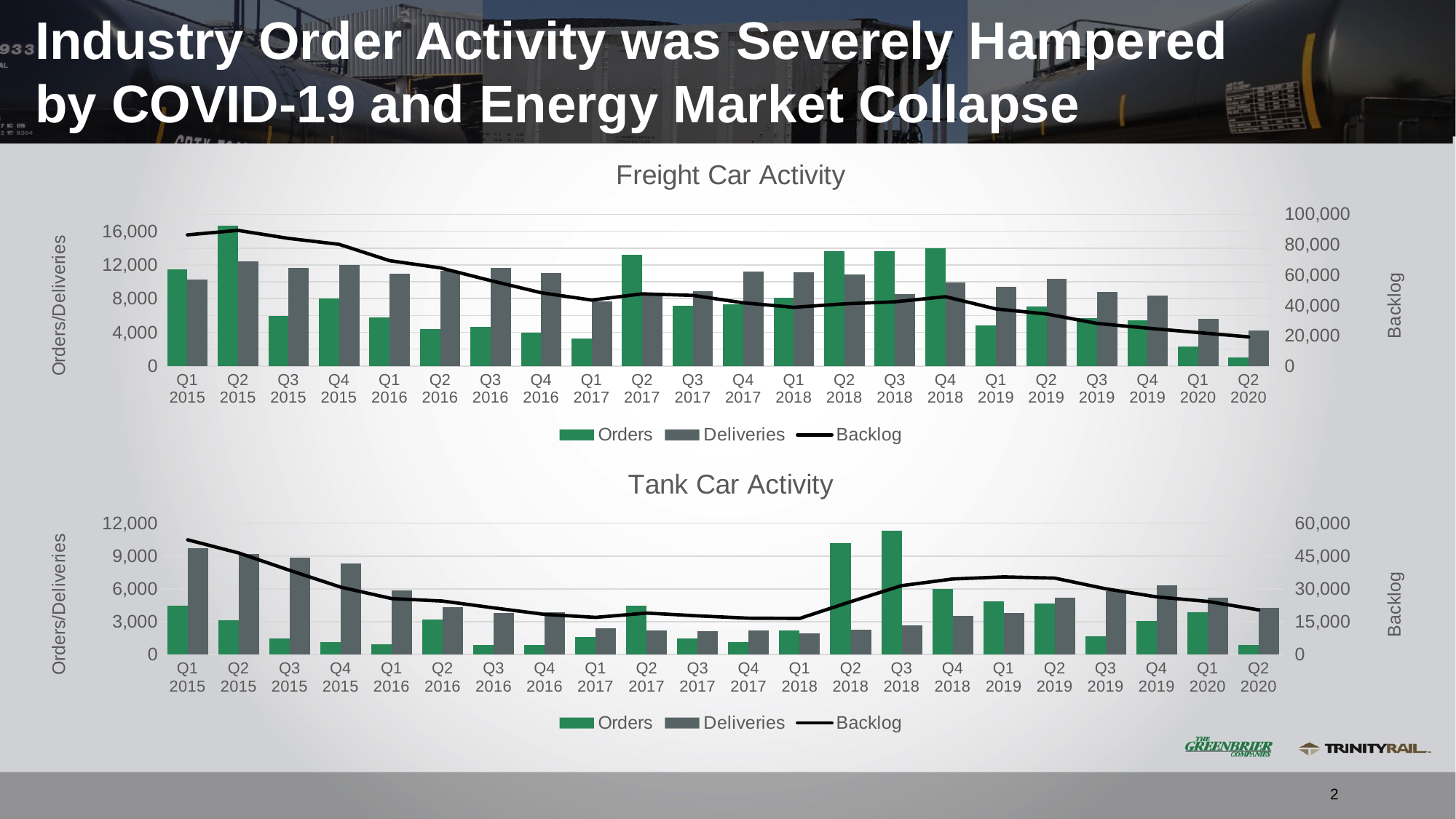
In the Tank Car Activity chart, which quarter has the highest Orders bar? Q3 2018 In the Freight Car Activity chart, does the Backlog line rise or fall from Q1 2015 to Q2 2020? fall In the Tank Car Activity chart, which quarter has the highest Deliveries bar? Q1 2015 How many quarters are shown on the x axis of the Freight Car Activity chart? 22 In the Freight Car Activity chart, is the Orders value for Q1 2020 greater or less than 4,000? less How many series does the legend of the Tank Car Activity chart list? 3 In the Freight Car Activity chart, which quarter has the highest Orders bar? Q2 2015 In the Freight Car Activity chart, is the Orders value for Q2 2017 greater or less than 12,000? greater In the Freight Car Activity chart, which is larger in Q2 2017, Orders or Deliveries? Orders In the Tank Car Activity chart, is the Orders value for Q2 2018 greater or less than 9,000? greater What is the label of the right-hand vertical axis on the Tank Car Activity chart? Backlog In the Freight Car Activity chart, which quarter has the lowest Orders bar? Q2 2020